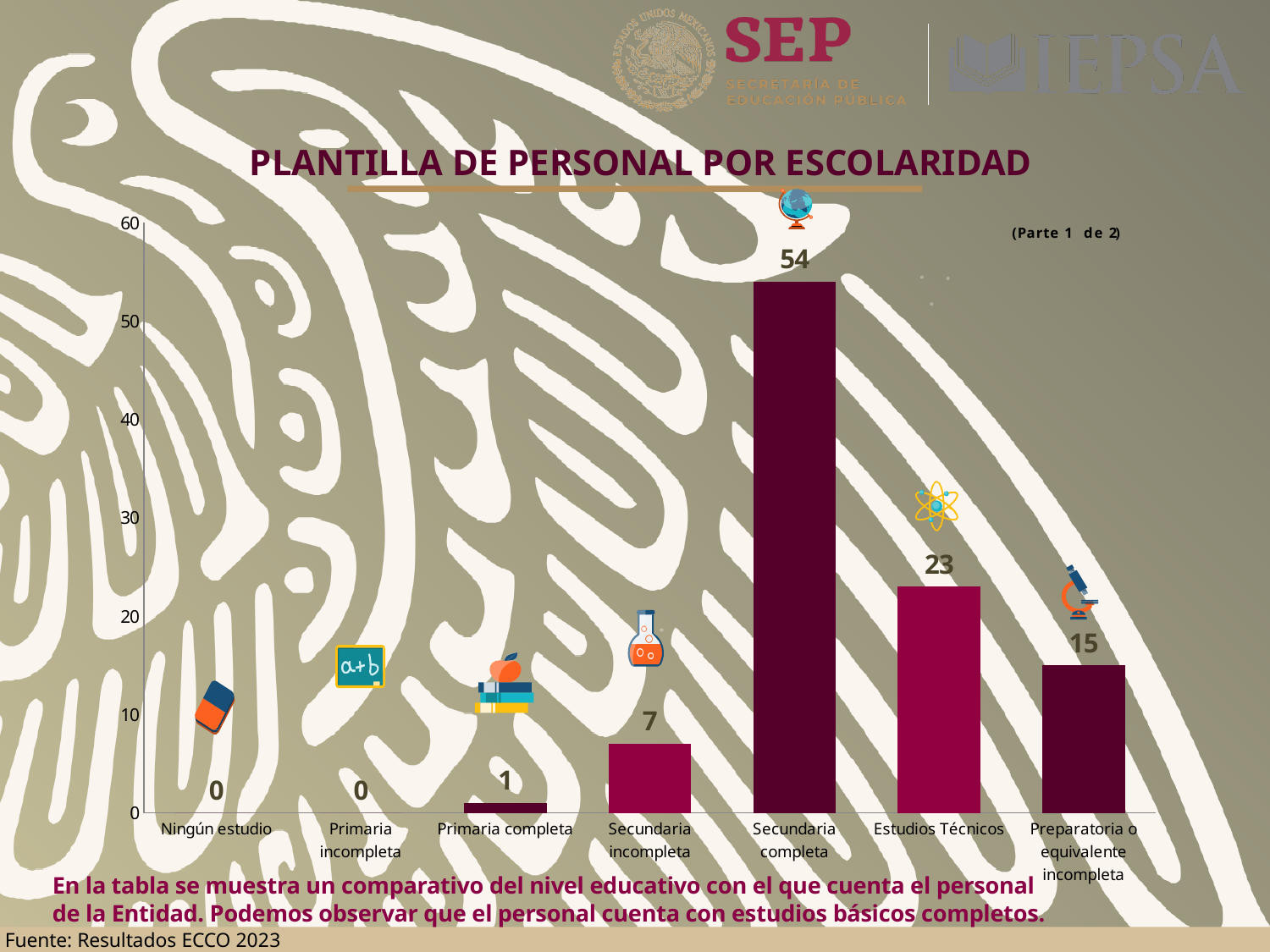
What is the value for Preparatoria o equivalente incompleta? 15 What is the value for Estudios Técnicos? 23 What is the value for Secundaria incompleta? 7 What is the difference between Secundaria completa and Estudios Técnicos? 31 Is the value for Secundaria completa greater or less than 50? greater What is the value for Primaria completa? 1 What is the value for Secundaria completa? 54 How many categories are shown on the x axis? 7 What kind of chart is shown? bar chart Which is larger, Estudios Técnicos or Preparatoria o equivalente incompleta? Estudios Técnicos What is the title of the chart? PLANTILLA DE PERSONAL POR ESCOLARIDAD Which category has the highest value? Secundaria completa